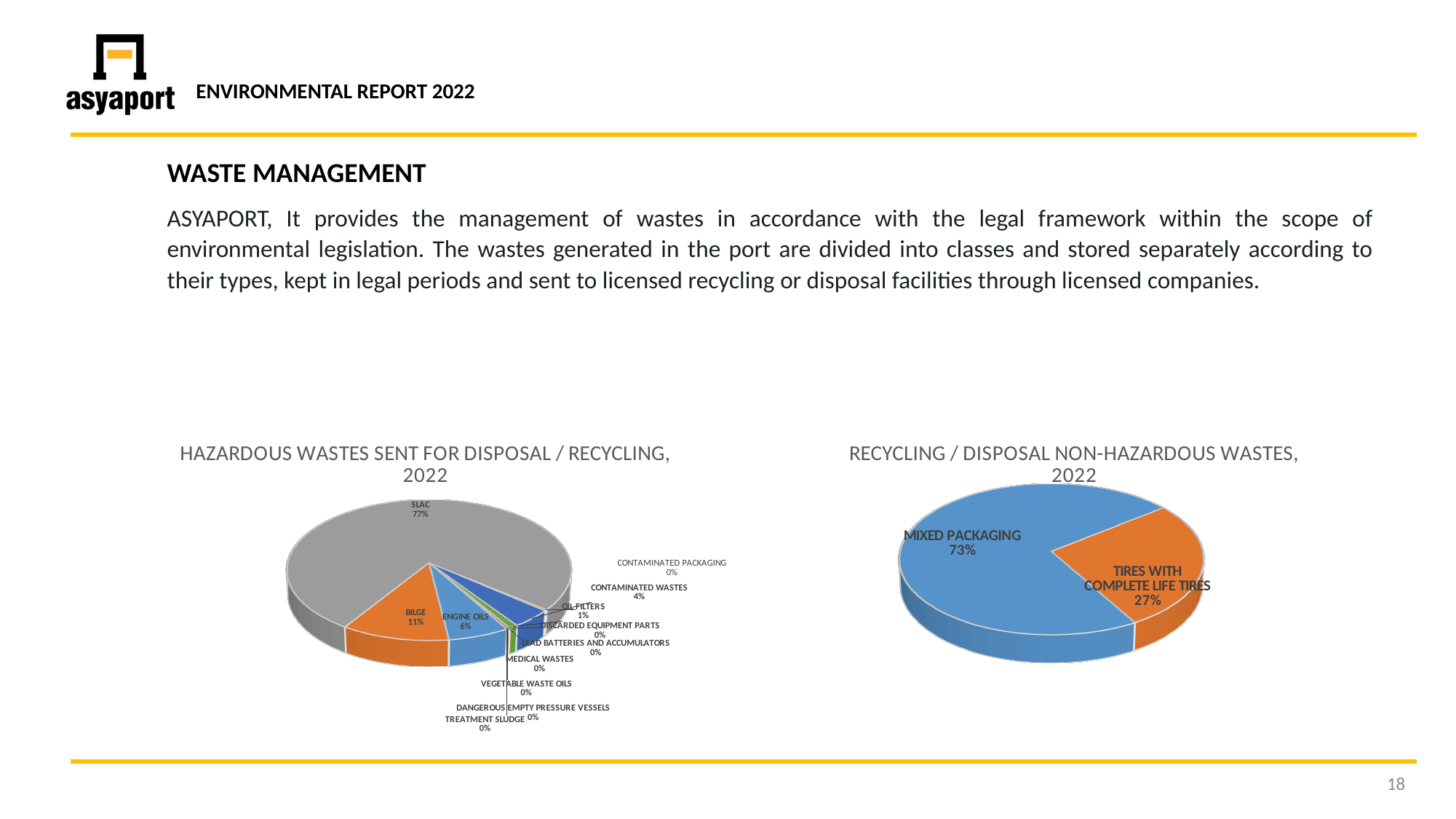
In the 'HAZARDOUS WASTES SENT FOR DISPOSAL / RECYCLING, 2022' chart, what share does BILGE have? 11% How many categories are shown in the 'RECYCLING / DISPOSAL NON-HAZARDOUS WASTES, 2022' chart? 2 In the 'HAZARDOUS WASTES SENT FOR DISPOSAL / RECYCLING, 2022' chart, what is the difference in percentage points between SLAC and BILGE? 66 In the 'HAZARDOUS WASTES SENT FOR DISPOSAL / RECYCLING, 2022' chart, which category has the largest share? SLAC In the 'HAZARDOUS WASTES SENT FOR DISPOSAL / RECYCLING, 2022' chart, which is larger, BILGE or ENGINE OILS? BILGE In the 'RECYCLING / DISPOSAL NON-HAZARDOUS WASTES, 2022' chart, what share does MIXED PACKAGING have? 73% What kind of chart is the 'HAZARDOUS WASTES SENT FOR DISPOSAL / RECYCLING, 2022' chart? Pie chart In the 'RECYCLING / DISPOSAL NON-HAZARDOUS WASTES, 2022' chart, which category has the smallest share? TIRES WITH COMPLETE LIFE TIRES In the 'HAZARDOUS WASTES SENT FOR DISPOSAL / RECYCLING, 2022' chart, what share does CONTAMINATED WASTES have? 4%